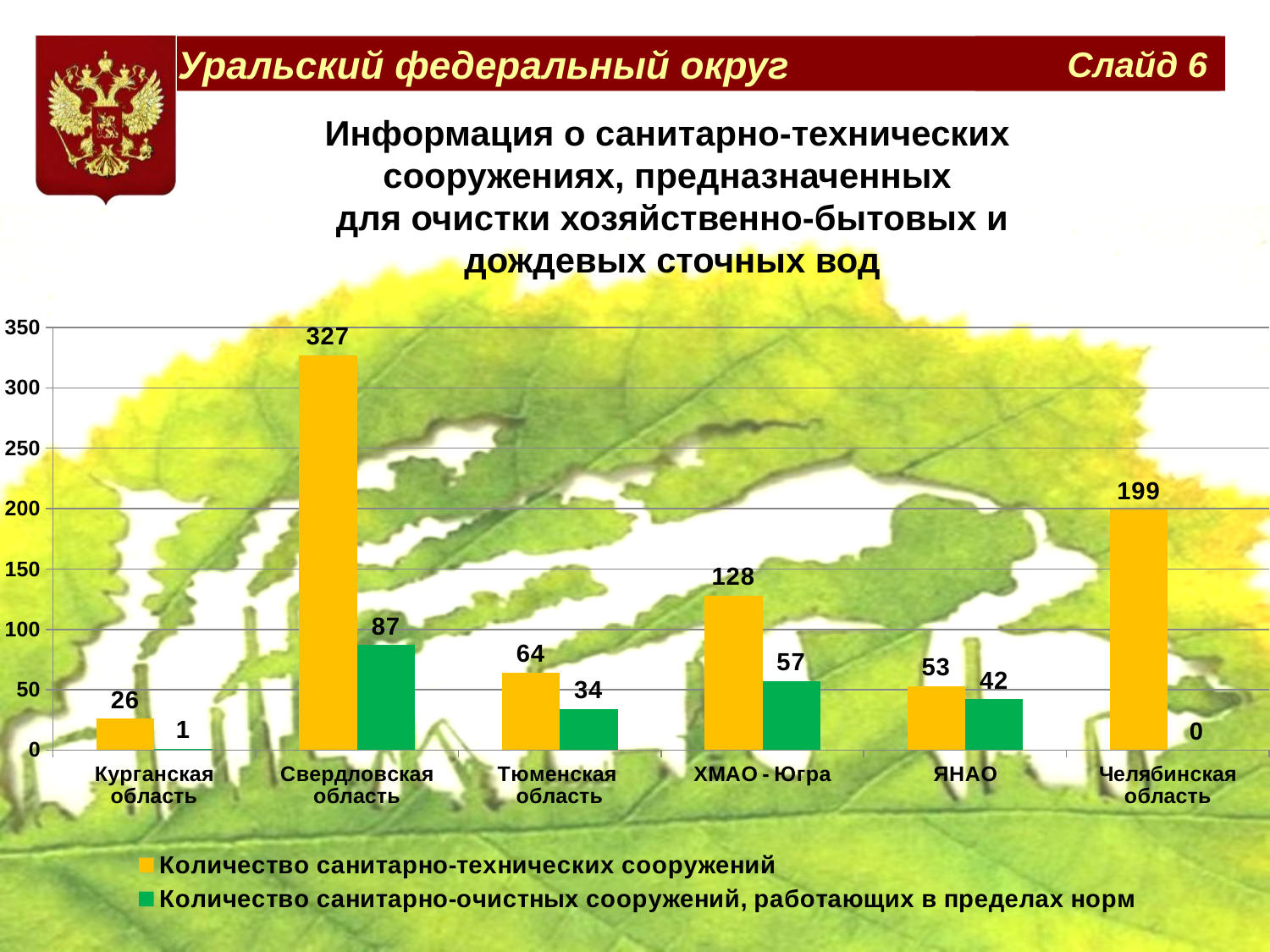
What kind of chart is shown on the slide? bar chart What colour represents 'Количество санитарно-очистных сооружений, работающих в пределах норм' in the chart? green Which region has the lowest value for 'Количество санитарно-технических сооружений'? Курганская область Which region has the highest value for 'Количество санитарно-технических сооружений'? Свердловская область Is the value of 'Количество санитарно-технических сооружений' for Тюменская область greater or less than 100? less What is the value of 'Количество санитарно-очистных сооружений, работающих в пределах норм' for Челябинская область? 0 How many regions are shown on the x axis of the chart? 6 Which is larger: 'Количество санитарно-технических сооружений' for ХМАО - Югра or for Челябинская область? Челябинская область How many series does the legend list? 2 What is the value of 'Количество санитарно-технических сооружений' for Свердловская область? 327 What is the value of 'Количество санитарно-очистных сооружений, работающих в пределах норм' for ХМАО - Югра? 57 What is the difference between 'Количество санитарно-технических сооружений' and 'Количество санитарно-очистных сооружений, работающих в пределах норм' for Свердловская область? 240